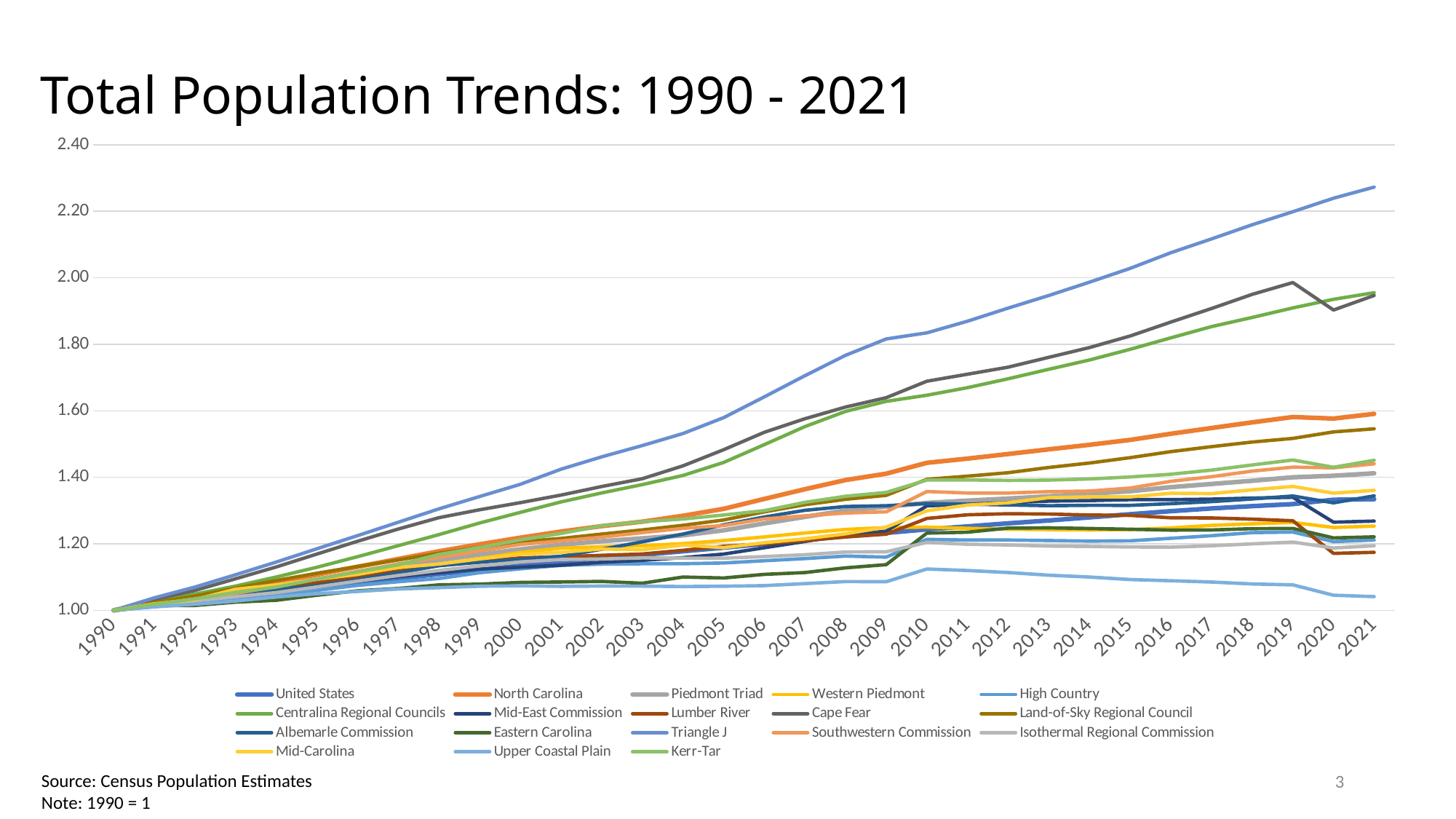
How many series does the legend list? 18 Is the value for North Carolina in 2021 greater or less than 1.40? greater Is the value of the highest line in 2021 greater or less than 2.20? greater Is the value of the lowest line in 2021 greater or less than 1.20? less What is the value of every series in 1990? 1.00 How many years are shown along the x axis? 32 Do the lines generally rise or fall from 1990 to 2021? rise What is the source cited below the chart? Census Population Estimates What kind of chart is shown on the slide? line chart What is the title of the chart? Total Population Trends: 1990 - 2021